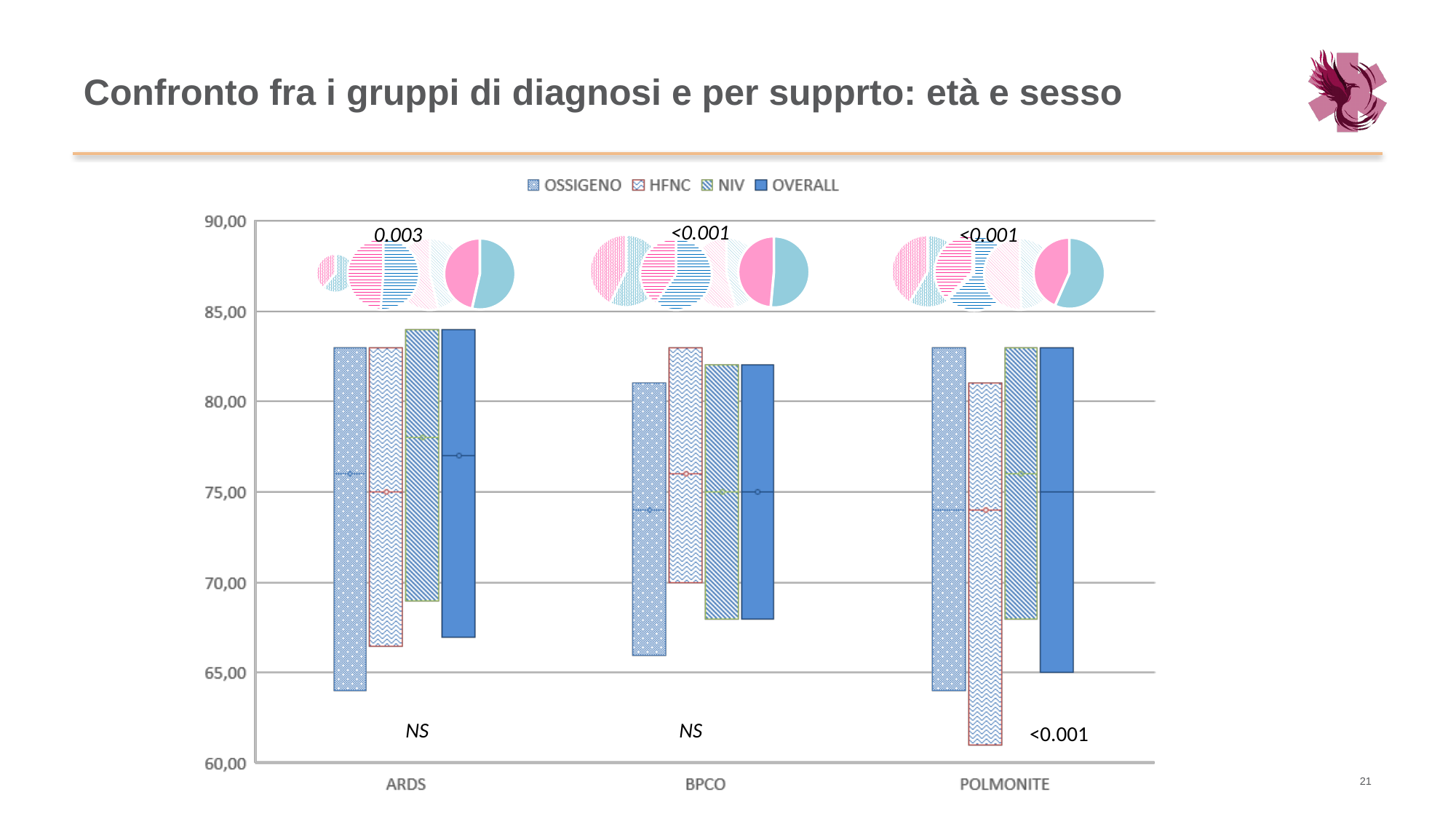
What is the first entry in the legend? OSSIGENO Is the bottom of the HFNC bar for POLMONITE greater or less than 65? less In the BPCO group, which bar extends lower: OSSIGENO or OVERALL? OSSIGENO What annotation is printed below the POLMONITE group? <0.001 How many diagnosis groups are shown on the x axis? 3 Is the bottom of the OSSIGENO bar for BPCO greater or less than 70? less What kind of chart is shown on the slide? bar chart How many series does the legend list? 4 In the POLMONITE group, which series has the bar that extends lowest? HFNC Is the top of the HFNC bar for BPCO greater or less than 80? greater